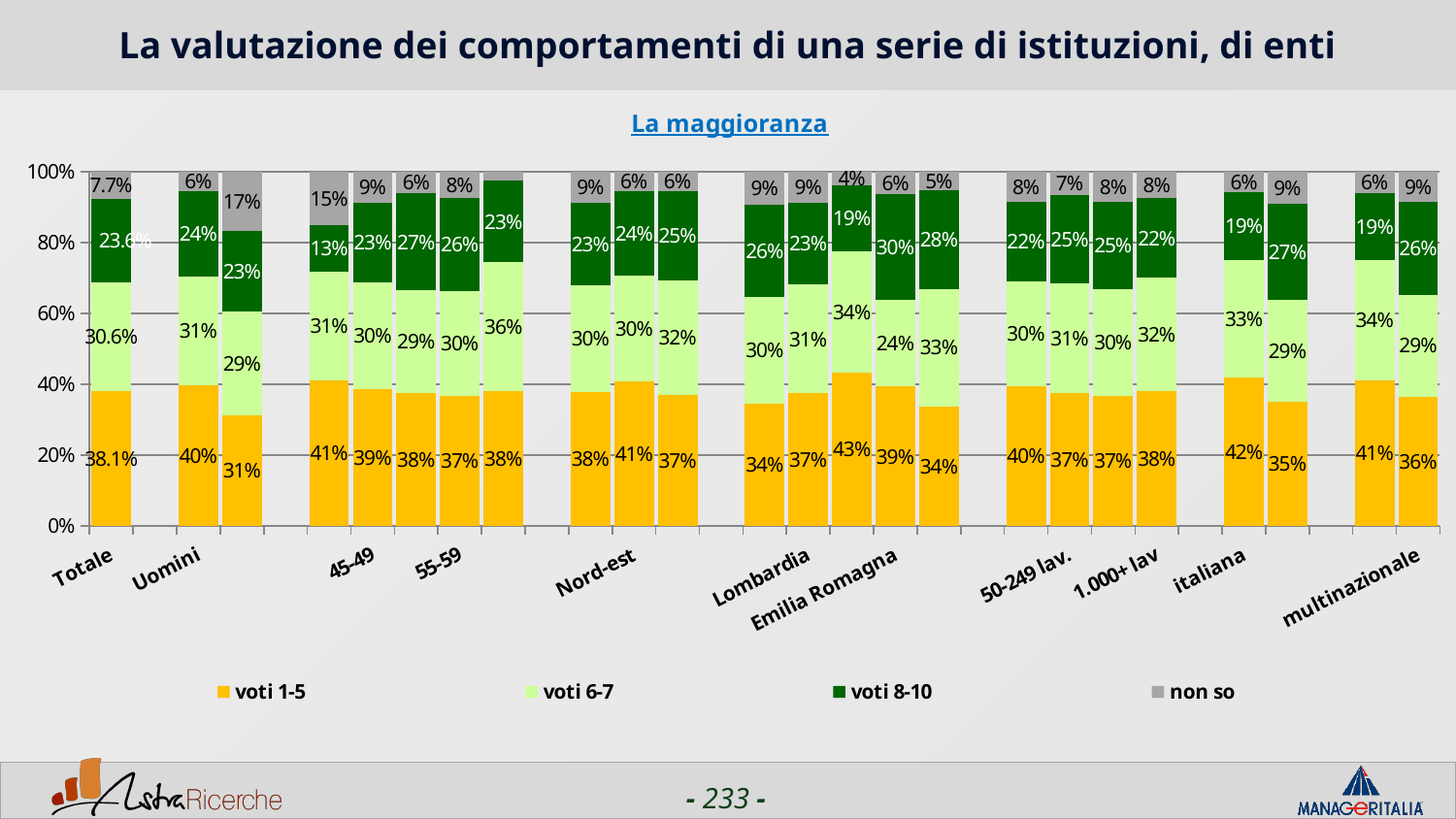
What is the value of 'voti 1-5' for Totale? 38.1% Which legend entry is shown in dark green? voti 8-10 What is the value of 'voti 1-5' for Nord-est? 41% What is the value of 'voti 6-7' for Totale? 30.6% Which is larger for Uomini: 'voti 1-5' or 'voti 6-7'? voti 1-5 What is the value of 'voti 8-10' for Uomini? 24% What is the value of 'non so' for Totale? 7.7% What is the value of 'voti 8-10' for 55-59? 26% What is the value of 'voti 1-5' for Uomini? 40% What is the difference between 'voti 1-5' for Uomini and 'voti 1-5' for 55-59? 3% How many series does the legend list? 4 What kind of chart is shown on the slide? Stacked bar chart